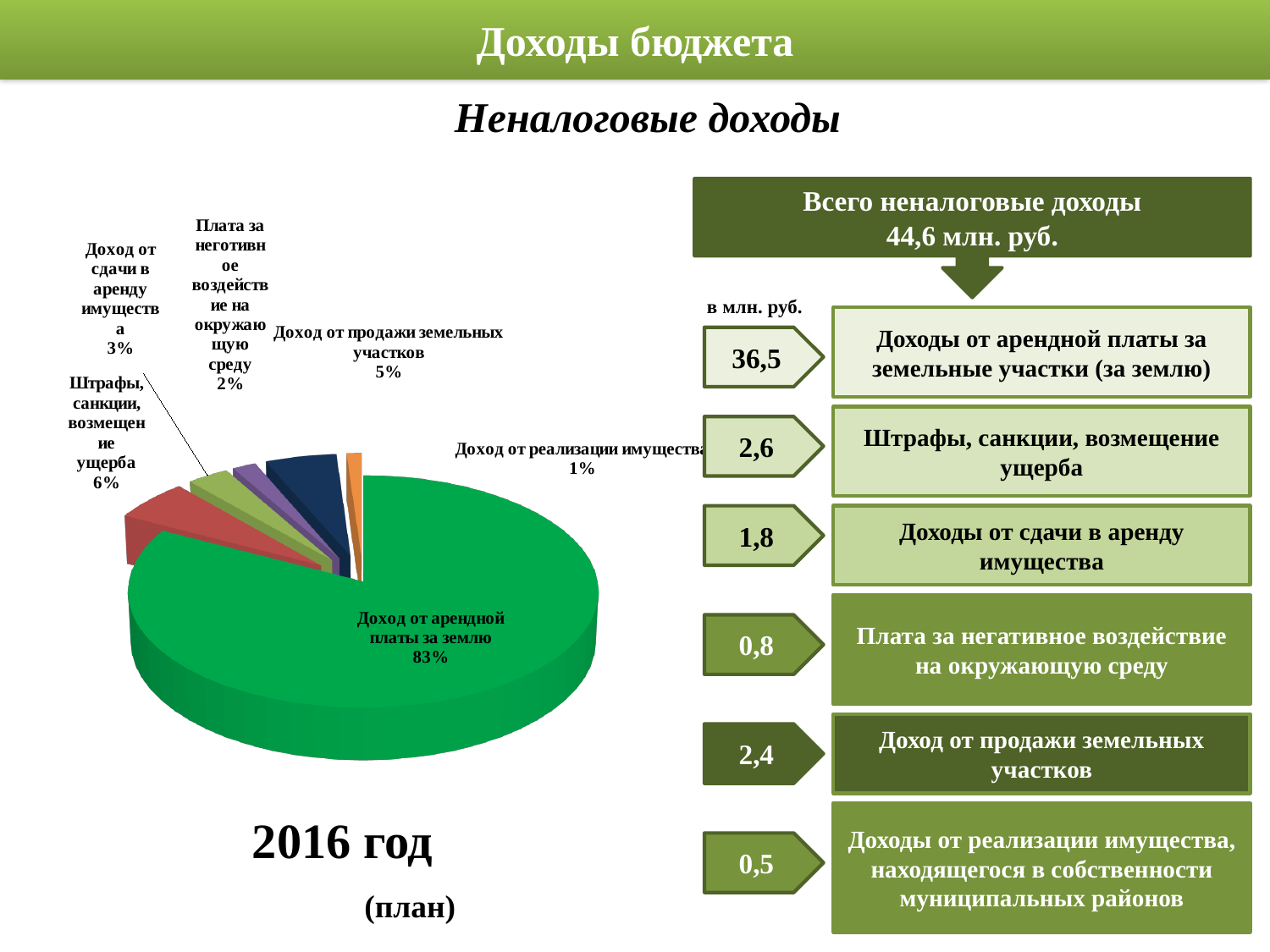
What kind of chart is shown on the slide? Pie chart How many slices does the pie chart have? 6 What share of the pie does "Доход от сдачи в аренду имущества" have? 3% What share of the pie does "Плата за негативное воздействие на окружающую среду" have? 2% Which has the larger share: "Штрафы, санкции, возмещение ущерба" or "Доход от продажи земельных участков"? Штрафы, санкции, возмещение ущерба What share of the pie does "Доход от реализации имущества" have? 1% By how many percentage points does the share of "Доход от арендной платы за землю" exceed the share of "Штрафы, санкции, возмещение ущерба"? 77 percentage points Which slice of the pie chart is the largest? Доход от арендной платы за землю Which slice of the pie chart is the smallest? Доход от реализации имущества